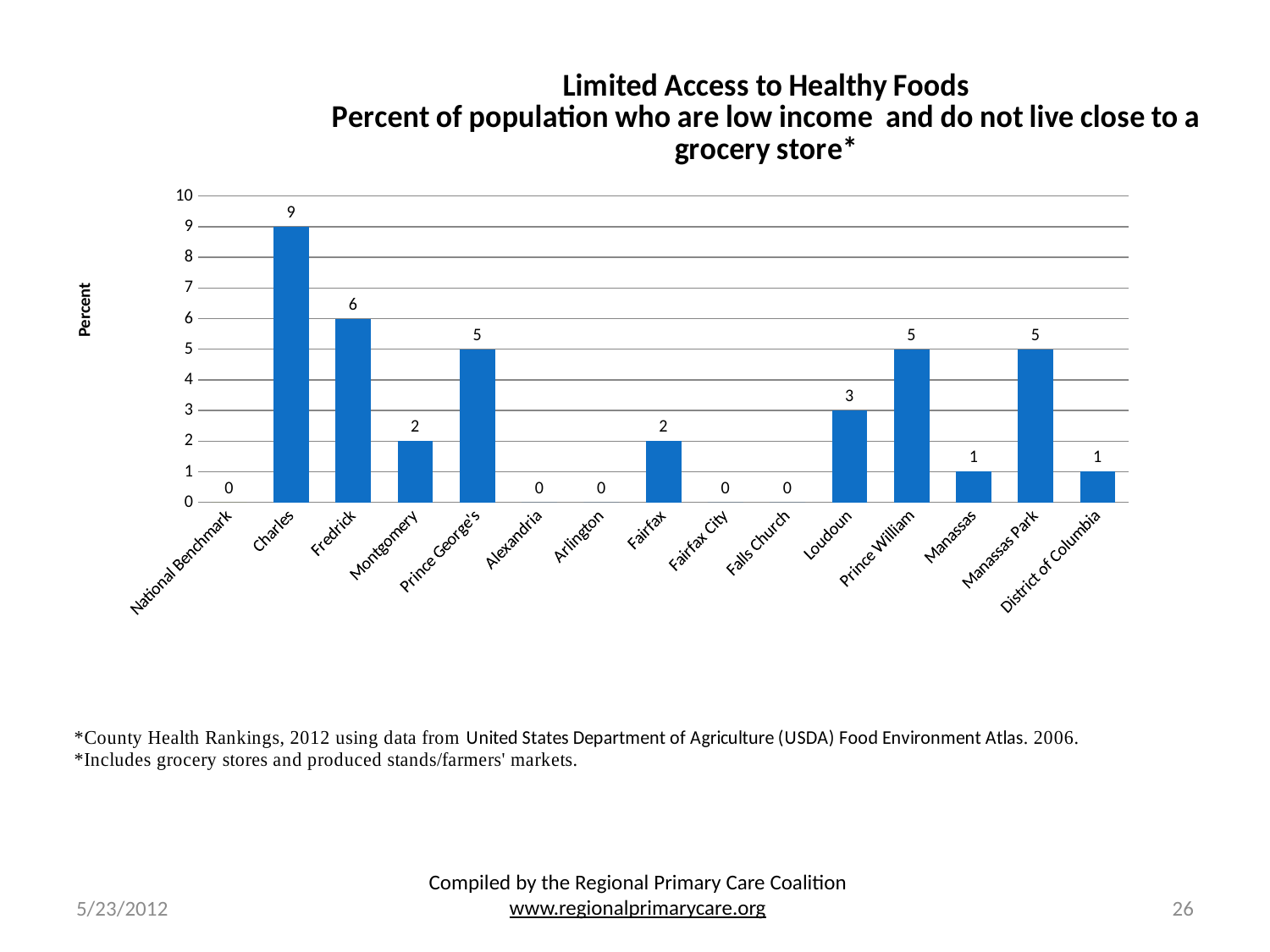
What is the value for Loudoun? 3 What is the value for Charles? 9 Which is larger, the value for Montgomery or the value for Loudoun? Loudoun Is the value for Fredrick greater or less than 5? greater What is the difference between the values for Charles and Fredrick? 3 How many categories are shown on the x axis? 15 What is the value for Prince George's? 5 What is the label of the y axis? Percent Which category has the highest value? Charles What kind of chart is shown on the slide? bar chart How many categories have a value of 0? 5 What is the value for District of Columbia? 1